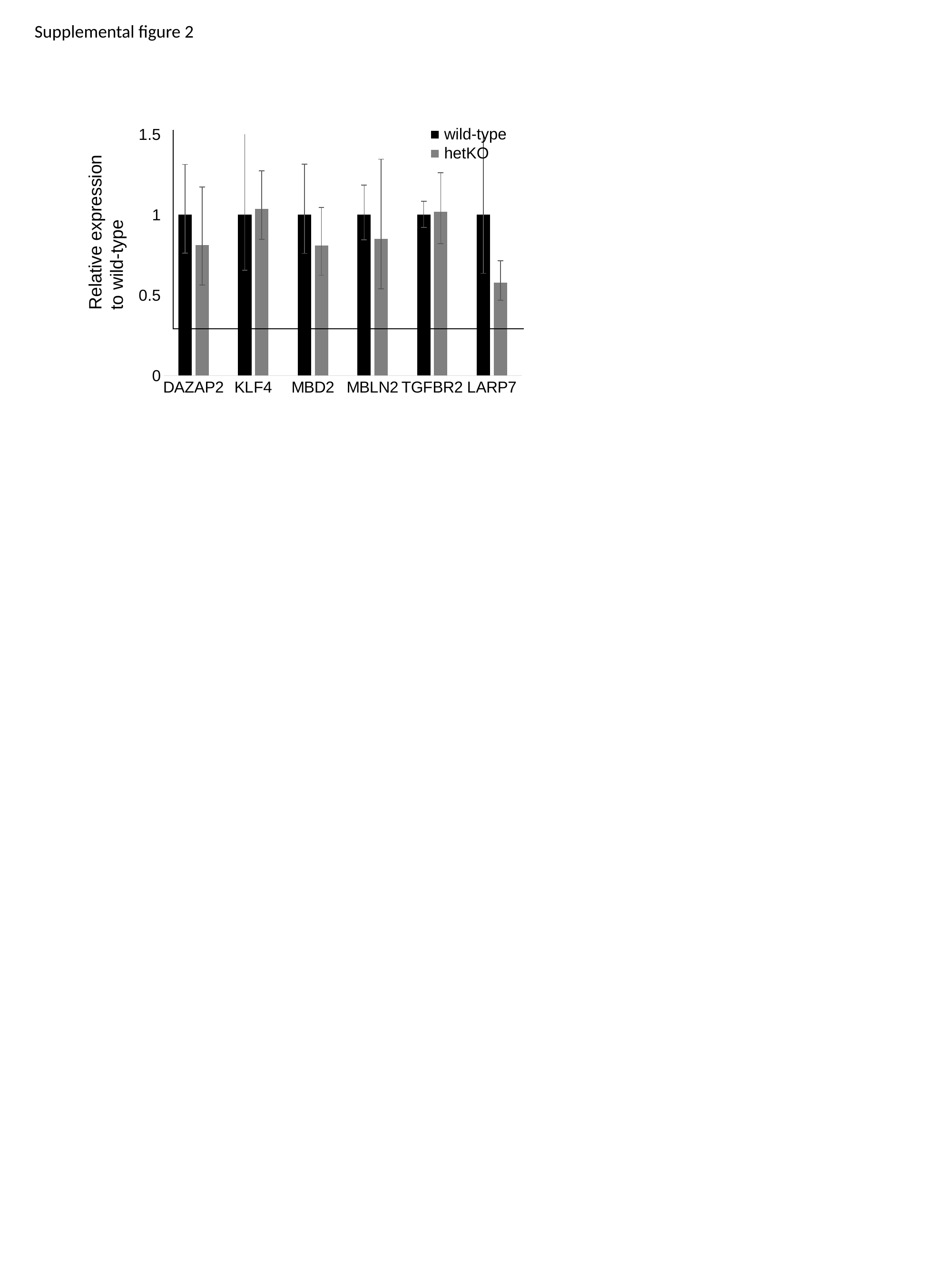
What is the wild-type value for LARP7? 1 Which colour represents the hetKO series in the legend? grey Is the hetKO value for LARP7 greater or less than 0.5? greater What kind of chart is shown on the slide? bar chart Which gene has the lowest hetKO value? LARP7 What is the wild-type value for DAZAP2? 1 How many series does the legend list? 2 Is the hetKO value for MBD2 greater or less than 1? less Is the hetKO value for DAZAP2 greater or less than 1? less For LARP7, which is larger, the wild-type value or the hetKO value? wild-type What is the label on the y axis? Relative expression to wild-type How many gene categories are shown on the x axis? 6